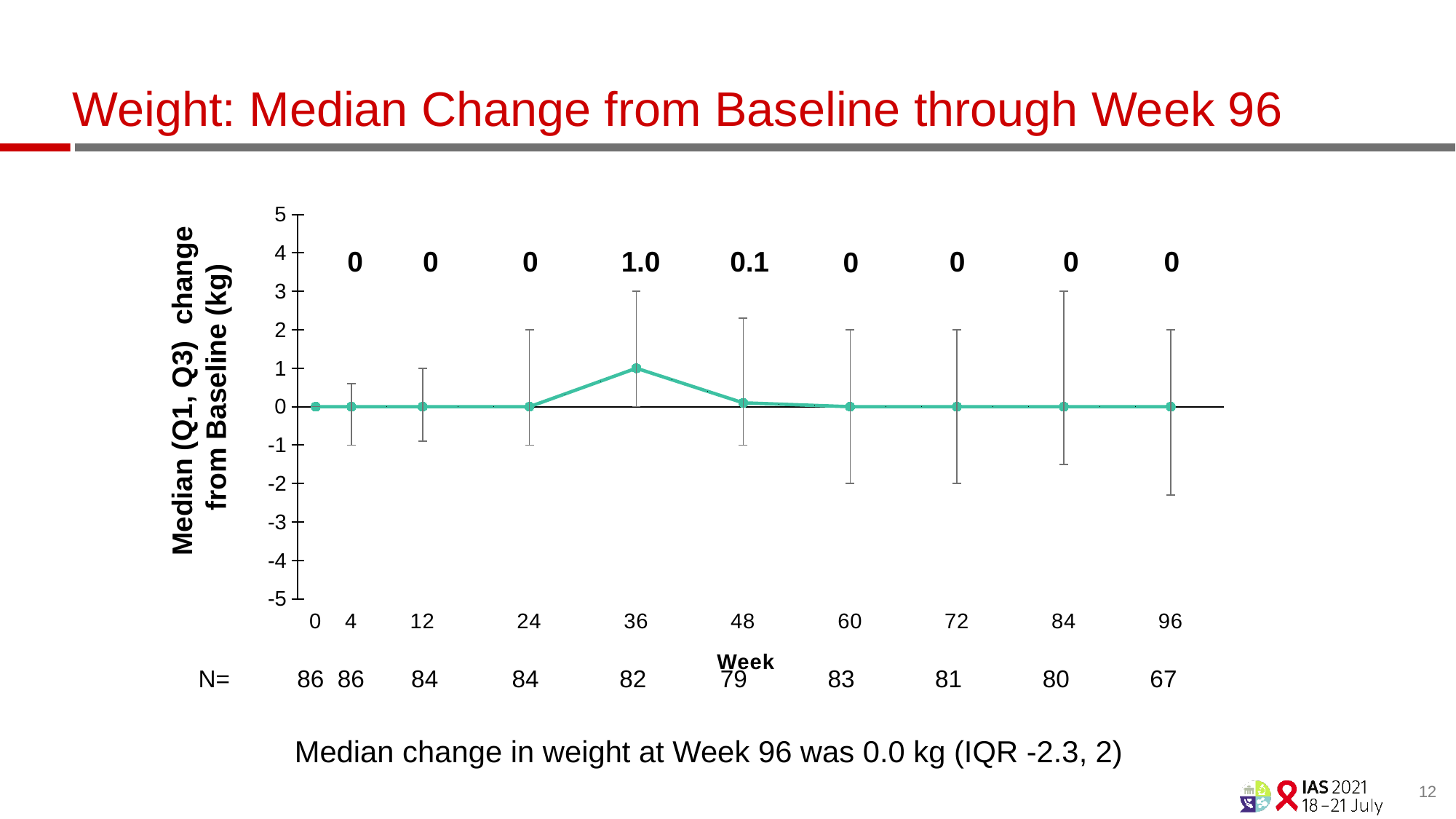
At which week is the median change from baseline in weight highest? Week 36 What is the label of the y axis? Median (Q1, Q3) change from Baseline (kg) What is the difference between the median change at Week 36 and at Week 48? 0.9 What is the median change from baseline in weight at Week 96? 0 How many weeks (time points) are plotted on the x axis? 10 Does the median change rise or fall from Week 36 to Week 48? Fall What is the median change from baseline in weight at Week 36? 1.0 What kind of chart is shown on the slide? Line chart Which is larger, the median change at Week 36 or at Week 48? Week 36 What is the N value shown for Week 96? 67 Is the median change at Week 36 greater or less than 2? less What is the median change from baseline in weight at Week 48? 0.1